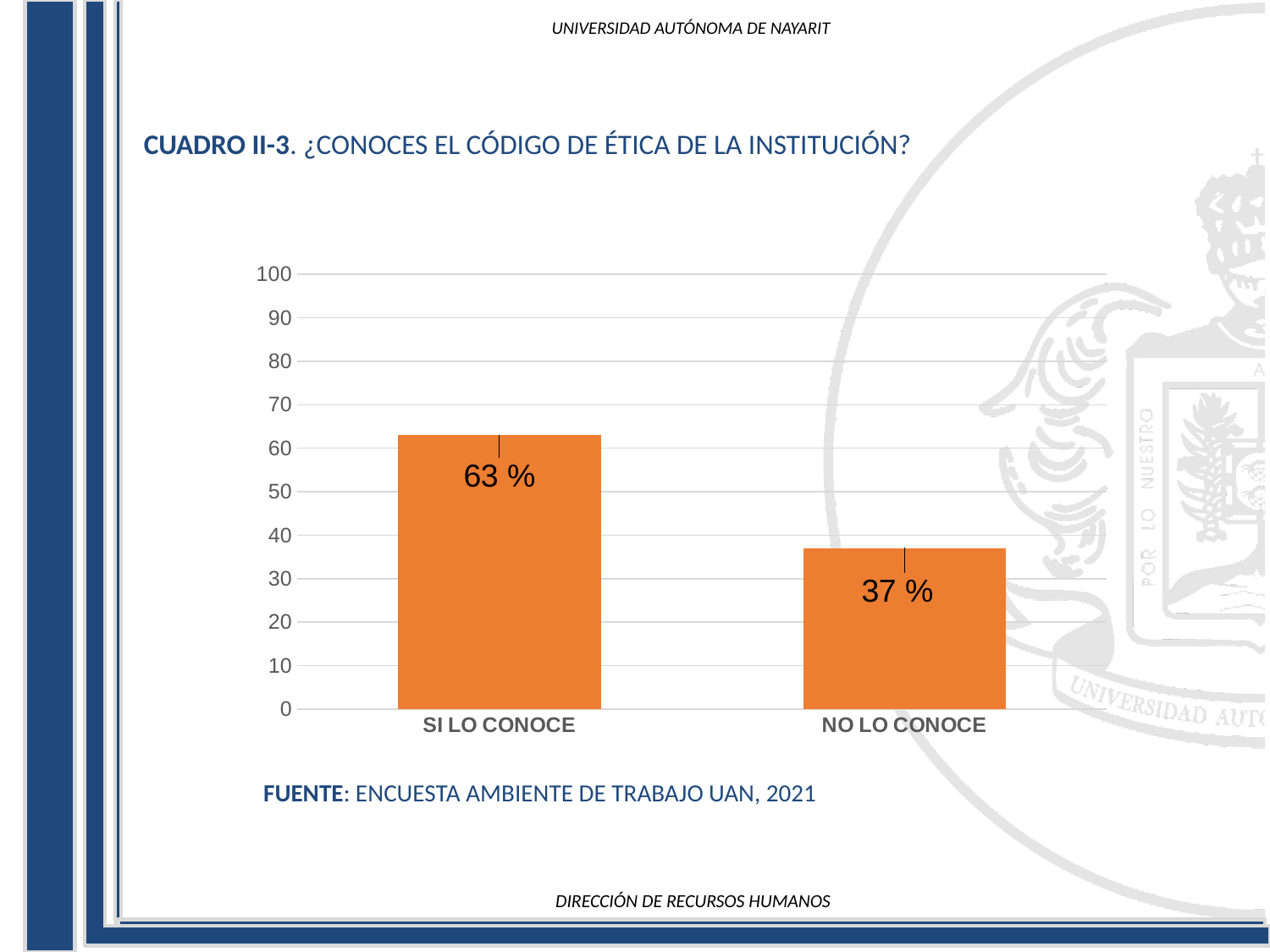
What is the difference between the values for SI LO CONOCE and NO LO CONOCE? 26 % Which category has the highest value? SI LO CONOCE What is the value for SI LO CONOCE? 63 % What is the title of the chart (CUADRO II-3)? ¿CONOCES EL CÓDIGO DE ÉTICA DE LA INSTITUCIÓN? How many categories are shown on the x axis? 2 What kind of chart is shown on the slide? bar chart Is the value for SI LO CONOCE greater or less than 60? greater Is the value for NO LO CONOCE greater or less than 40? less Which category has the lowest value? NO LO CONOCE What is the value for NO LO CONOCE? 37 % Which is larger, the value for SI LO CONOCE or the value for NO LO CONOCE? SI LO CONOCE What colour are the bars in the chart? orange